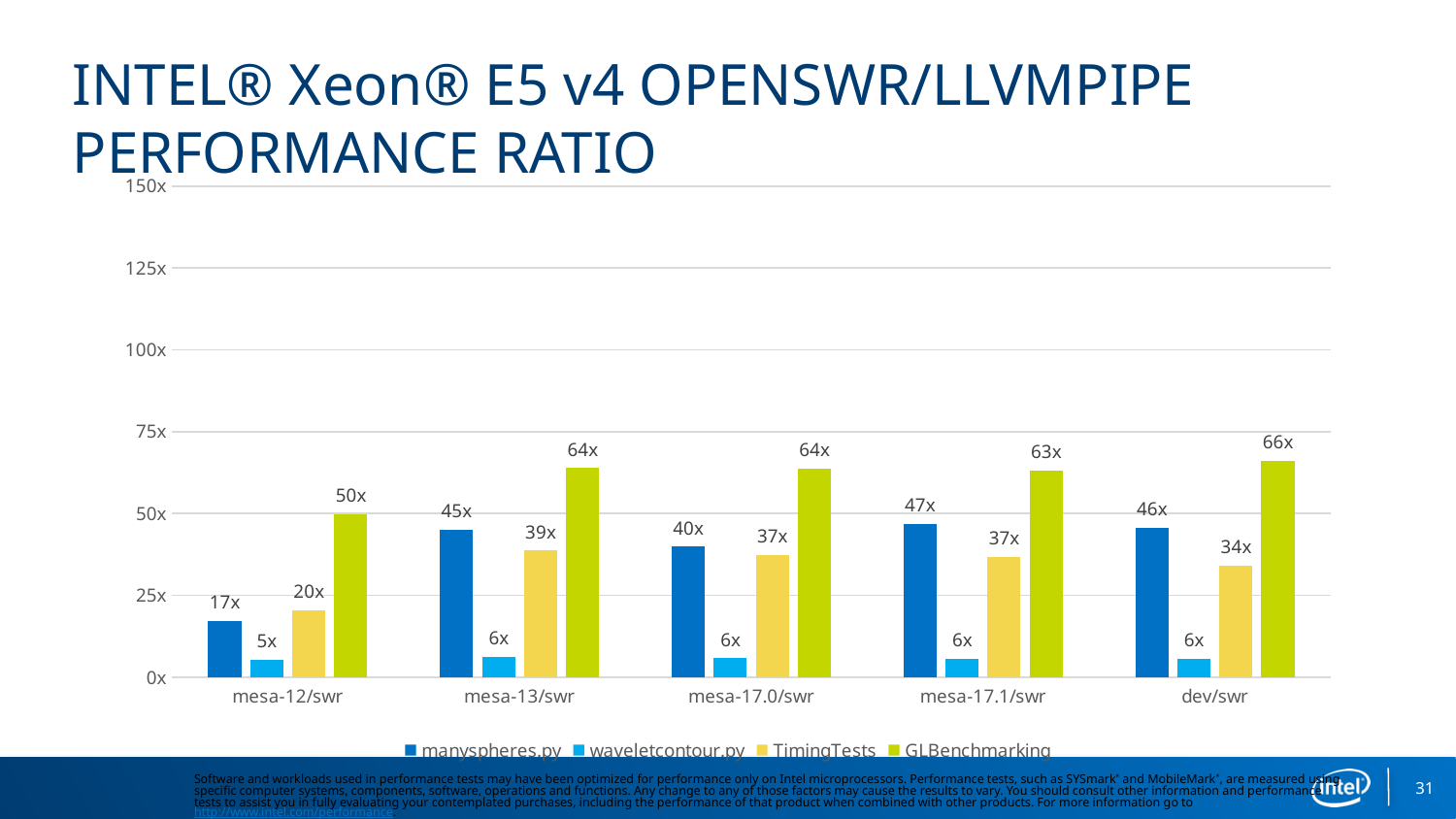
Which category has the highest GLBenchmarking value? dev/swr What is the TimingTests value for mesa-13/swr? 39x How many categories are shown on the x axis? 5 Which is larger, the manyspheres.py value for mesa-13/swr or the manyspheres.py value for mesa-17.0/swr? mesa-13/swr Which category has the lowest manyspheres.py value? mesa-12/swr What kind of chart is shown on the slide? bar chart How many series does the legend list? 4 Which series is shown in green in the legend? GLBenchmarking What is the waveletcontour.py value for mesa-12/swr? 5x What is the manyspheres.py value for mesa-12/swr? 17x What is the GLBenchmarking value for dev/swr? 66x What is the difference between the GLBenchmarking value and the manyspheres.py value for mesa-17.1/swr? 16x